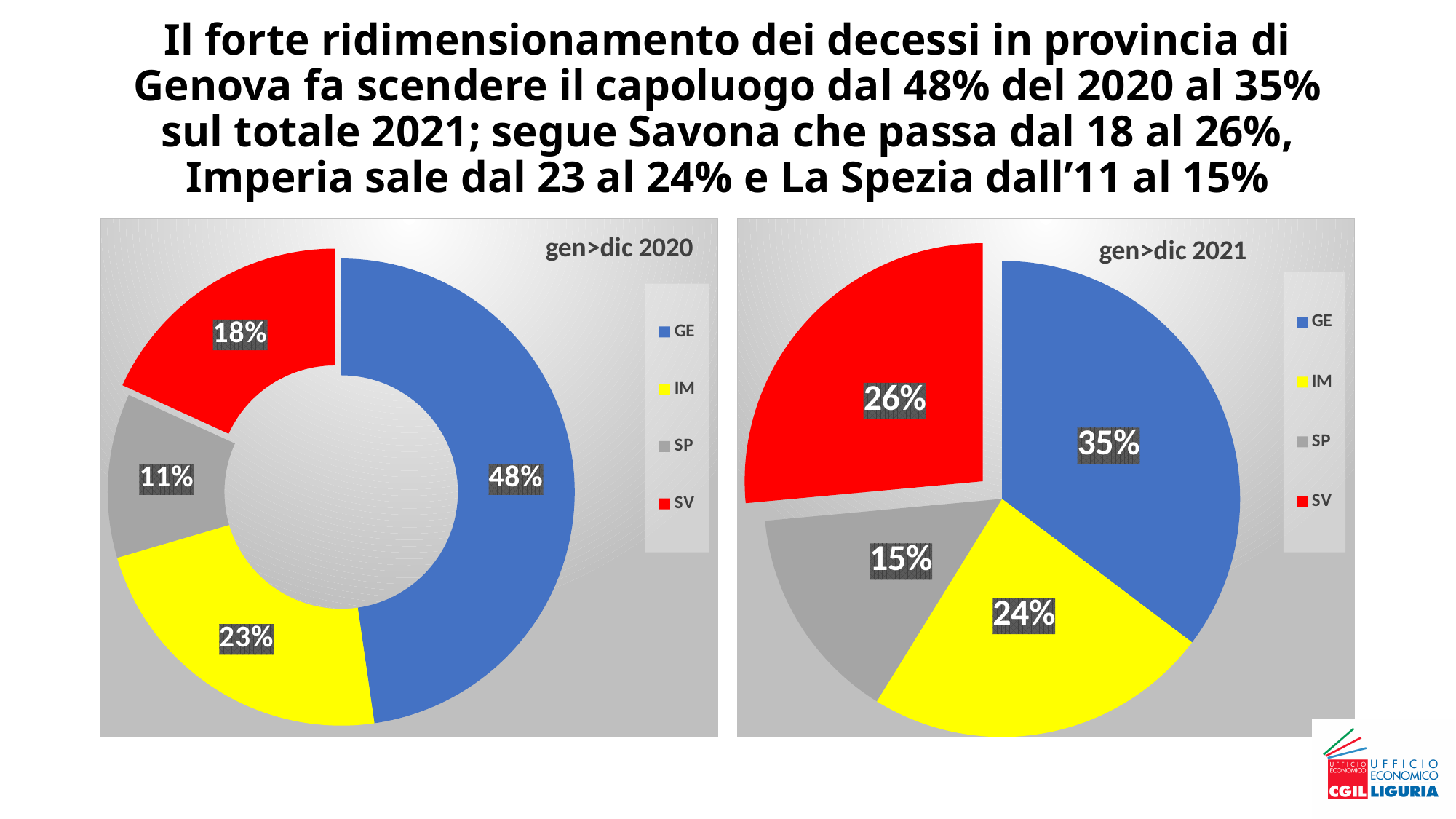
In the 'gen>dic 2020' chart, what share does GE have? 48% In the 'gen>dic 2020' chart, what share does SP have? 11% In the 'gen>dic 2020' chart, what is the difference between the GE share and the IM share? 25% How many entries does the legend of the 'gen>dic 2020' chart list? 4 In the 'gen>dic 2020' chart, which category has the largest slice? GE In the 'gen>dic 2021' chart, what share does IM have? 24% In the 'gen>dic 2021' chart, which category has the smallest slice? SP What kind of chart is the 'gen>dic 2021' chart? Pie chart How many slices does the 'gen>dic 2021' chart have? 4 In the 'gen>dic 2020' chart, what colour is the SV slice? Red In the 'gen>dic 2021' chart, which is larger, the SV slice or the IM slice? SV In the 'gen>dic 2021' chart, what share does SV have? 26%